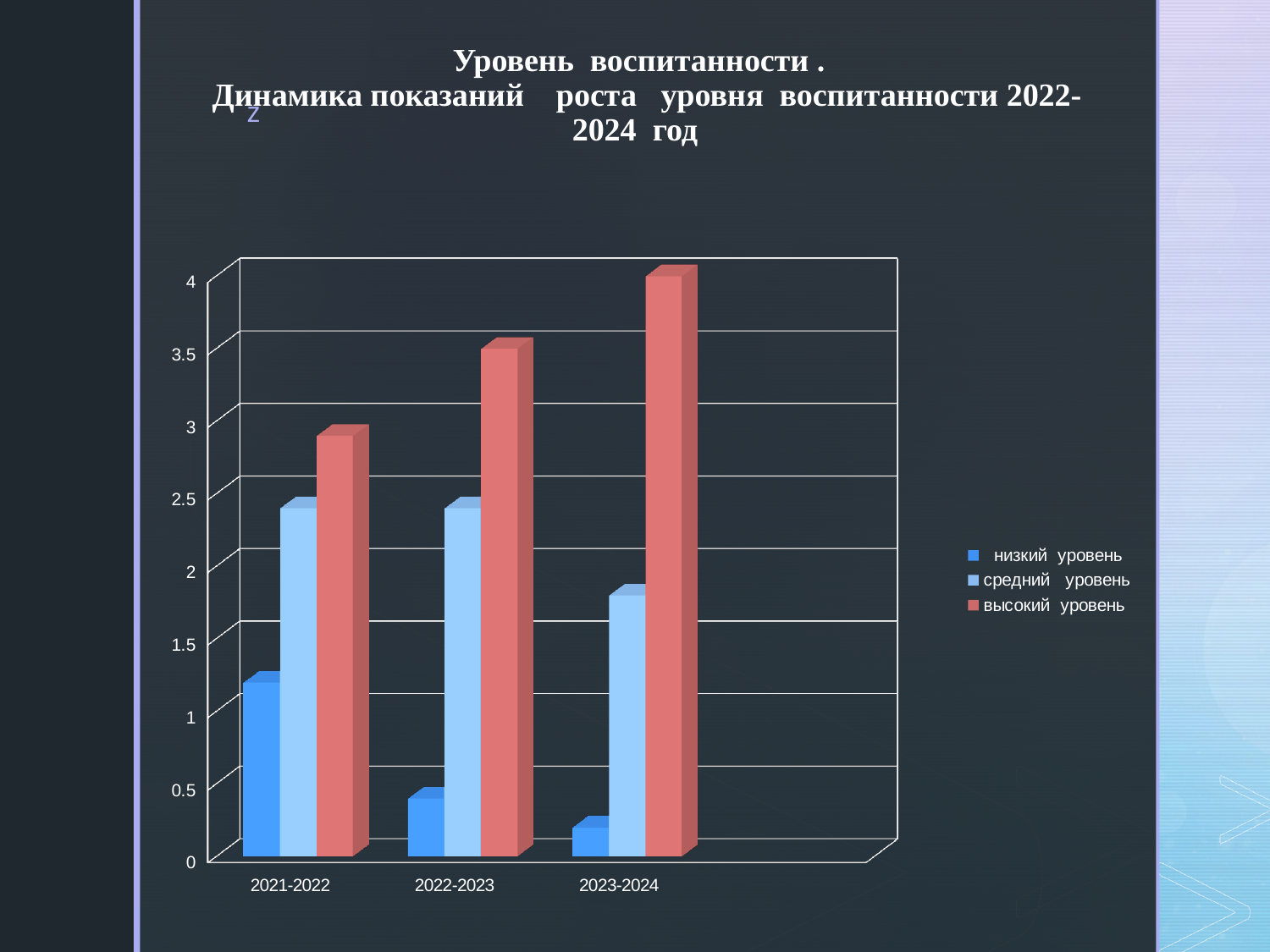
What kind of chart is shown on the slide? bar chart In which year category is the высокий уровень bar the highest? 2023-2024 How many year categories are shown on the x axis? 3 Do the values for высокий уровень rise or fall from 2021-2022 to 2023-2024? rise How many series does the legend list? 3 Is the value for низкий уровень in 2023-2024 greater or less than 0.5? less Is the value for высокий уровень in 2023-2024 greater or less than 3.5? greater Is the value for низкий уровень in 2021-2022 greater or less than 1? greater Which series is shown in red in the legend? высокий уровень In which year category is the низкий уровень bar the lowest? 2023-2024